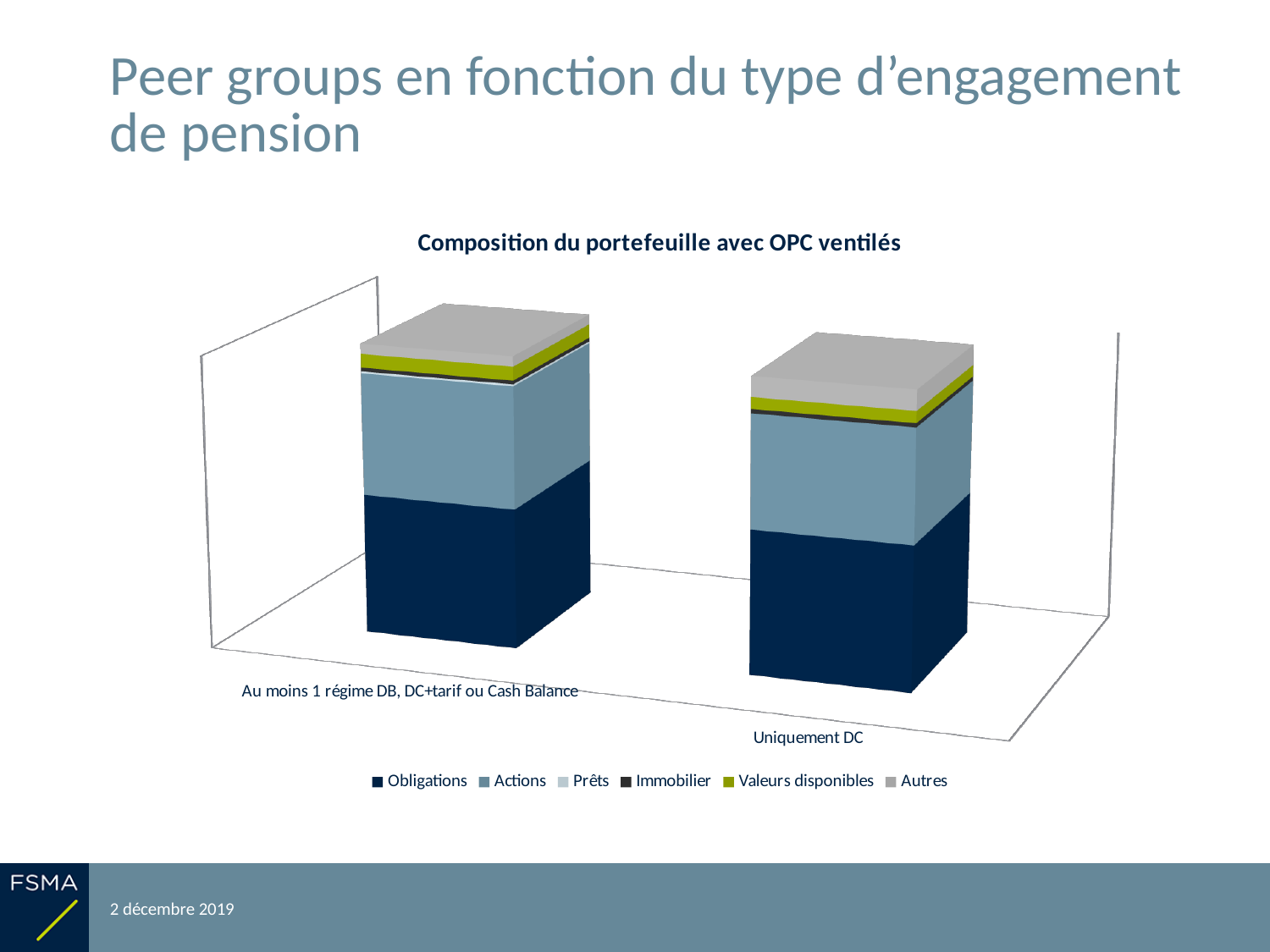
In the bar for 'Uniquement DC', which segment is larger: Obligations or Actions? Obligations In the bar for 'Uniquement DC', which segment is larger: Autres or Immobilier? Autres How many categories (bars) are shown in the chart? 2 In the bar for 'Au moins 1 régime DB, DC+tarif ou Cash Balance', which series forms the largest segment? Obligations What is the label of the second category on the x axis? Uniquement DC In the bar for 'Uniquement DC', which series forms the largest segment? Obligations What is the title of the chart? Composition du portefeuille avec OPC ventilés In the bar for 'Au moins 1 régime DB, DC+tarif ou Cash Balance', which segment is larger: Actions or Valeurs disponibles? Actions What kind of chart is shown on the slide? Stacked bar chart Which series is listed first in the legend? Obligations How many series does the legend list? 6